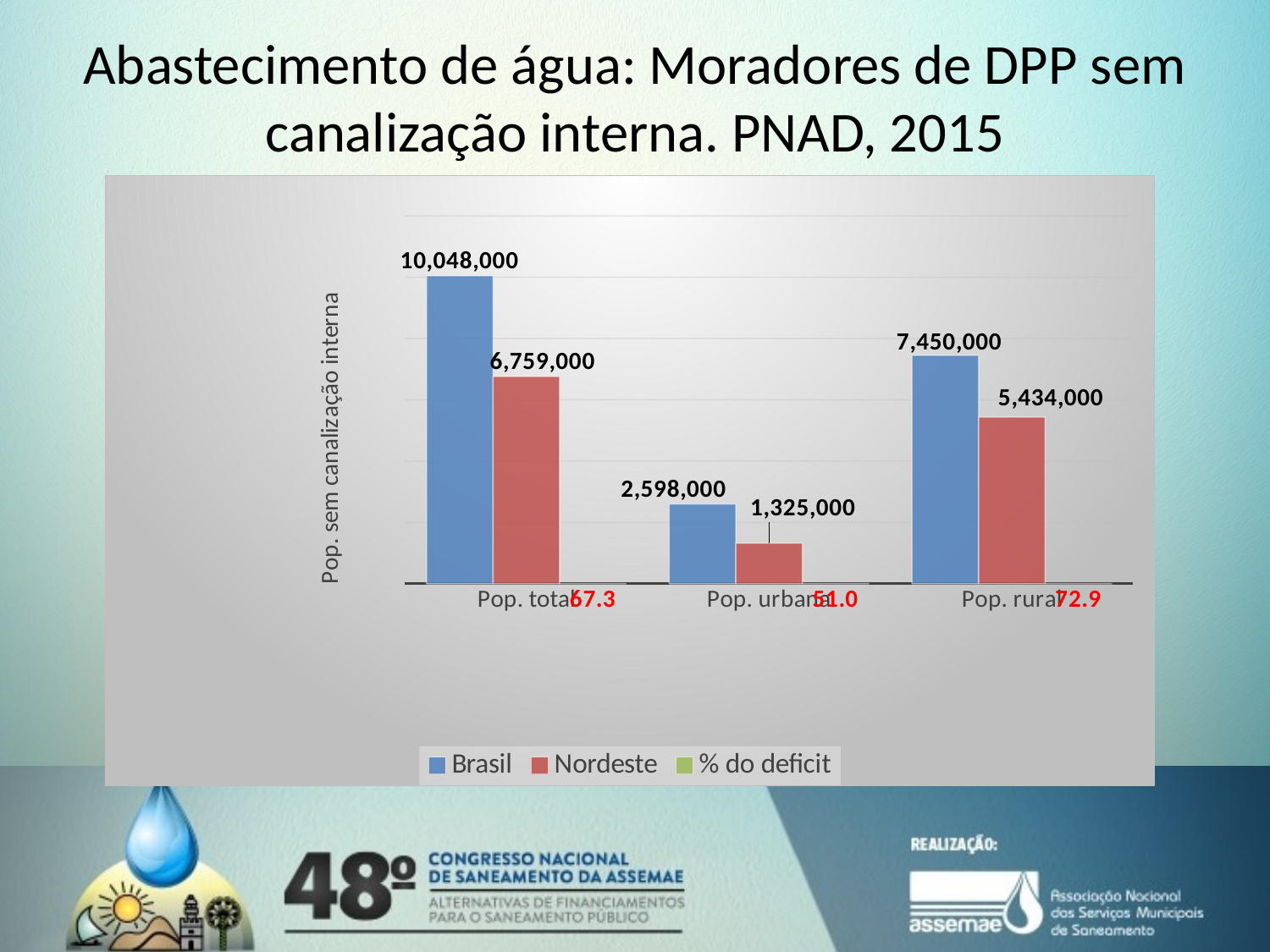
What is the label of the vertical axis? Pop. sem canalização interna What is the value for Nordeste in the Pop. urbana category? 1,325,000 Which is larger: the Brasil value for Pop. rural or the Nordeste value for Pop. total? Brasil value for Pop. rural Which category has the highest value for Brasil? Pop. total Which category has the lowest value for Nordeste? Pop. urbana What kind of chart is shown on the slide? Bar chart What is the % do deficit value shown for Pop. rural? 72.9 How many categories are shown on the x axis? 3 What is the value for Nordeste in the Pop. rural category? 5,434,000 What is the value for Brasil in the Pop. total category? 10,048,000 What is the difference between the Brasil and Nordeste values in the Pop. total category? 3,289,000 How many series does the legend list? 3